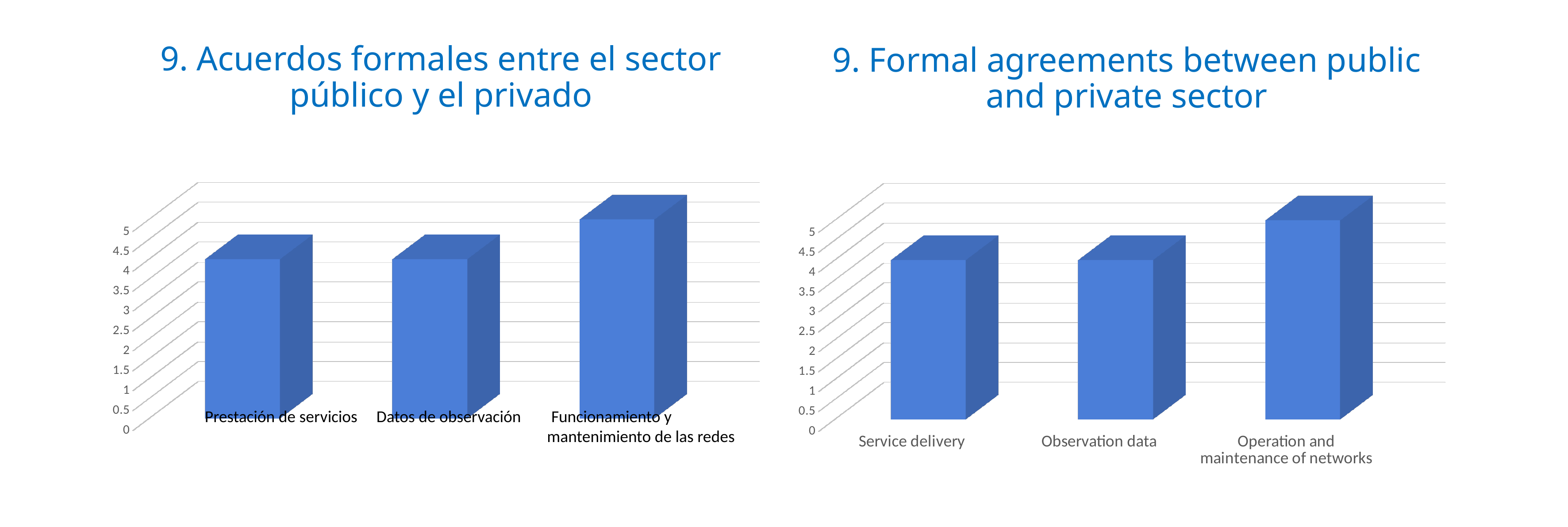
On the left chart, is the value for Prestación de servicios greater or less than 5? less On the left chart, is the value for Funcionamiento y mantenimiento de las redes greater or less than 4? greater What kind of chart is the left chart titled '9. Acuerdos formales entre el sector público y el privado'? bar chart On the right chart titled '9. Formal agreements between public and private sector', which category has the highest value? Operation and maintenance of networks On the right chart, is the value for Operation and maintenance of networks greater or less than 4? greater On the left chart titled '9. Acuerdos formales entre el sector público y el privado', which category has the highest value? Funcionamiento y mantenimiento de las redes On the left chart, which is larger: the value for Datos de observación or the value for Funcionamiento y mantenimiento de las redes? Funcionamiento y mantenimiento de las redes What is the title of the right chart? 9. Formal agreements between public and private sector On the right chart, which is larger: the value for Service delivery or the value for Operation and maintenance of networks? Operation and maintenance of networks How many categories are shown on the right chart titled '9. Formal agreements between public and private sector'? 3